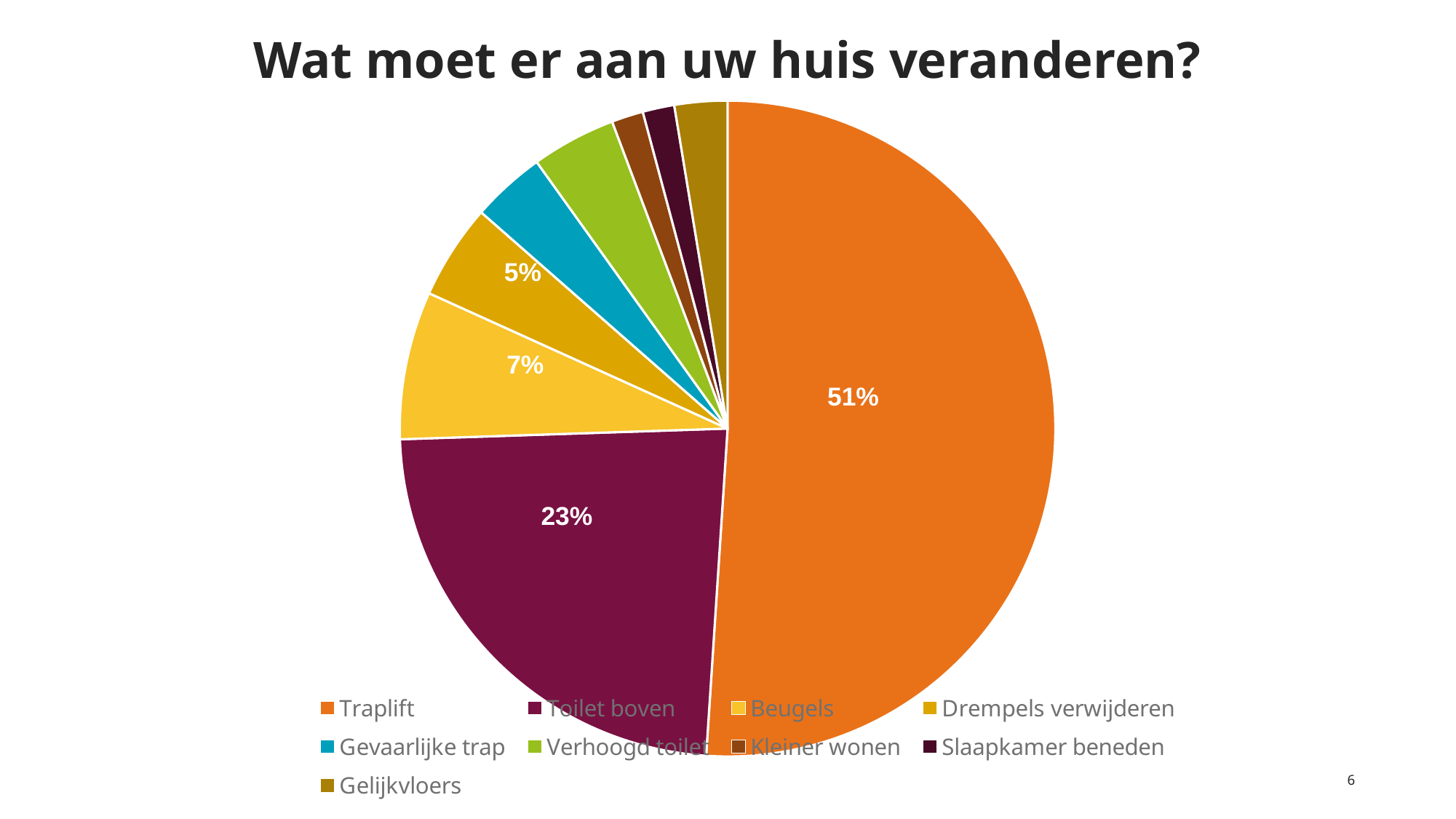
Which is larger, the slice for Beugels or the slice for Drempels verwijderen? Beugels What is the difference in percentage points between Traplift and Toilet boven? 28 Which category has the largest slice of the pie? Traplift What is the title of the chart? Wat moet er aan uw huis veranderen? Which is larger, the slice for Toilet boven or the slice for Beugels? Toilet boven What share of the pie does Traplift have? 51% What share of the pie does Drempels verwijderen have? 5% What share of the pie does Toilet boven have? 23% What share of the pie does Beugels have? 7% What kind of chart is shown on the slide? pie chart What colour is the slice for Traplift? orange How many categories does the legend list? 9